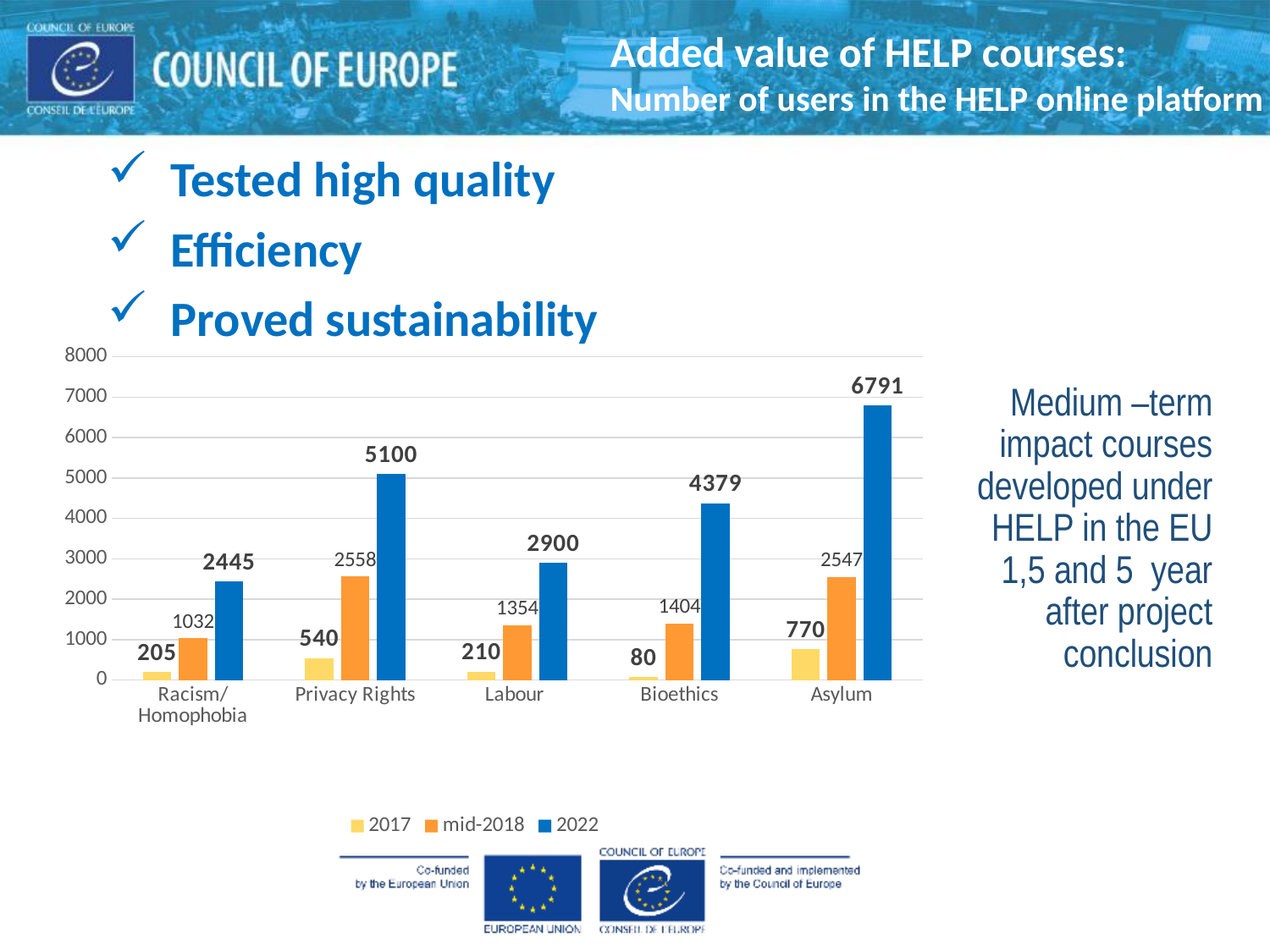
Which is larger: the mid-2018 value for Privacy Rights or the mid-2018 value for Asylum? Privacy Rights Is the 2022 value for Bioethics greater or less than 4000? greater How many categories are shown on the x axis? 5 What kind of chart is shown on the slide? bar chart Which category has the lowest 2017 value? Bioethics Which category has the highest 2022 value? Asylum What is the 2022 value for Privacy Rights? 5100 What is the difference between the 2022 value for Asylum and the 2022 value for Privacy Rights? 1691 How many series does the legend list? 3 What is the 2017 value for Bioethics? 80 What is the 2022 value for Asylum? 6791 What is the mid-2018 value for Labour? 1354